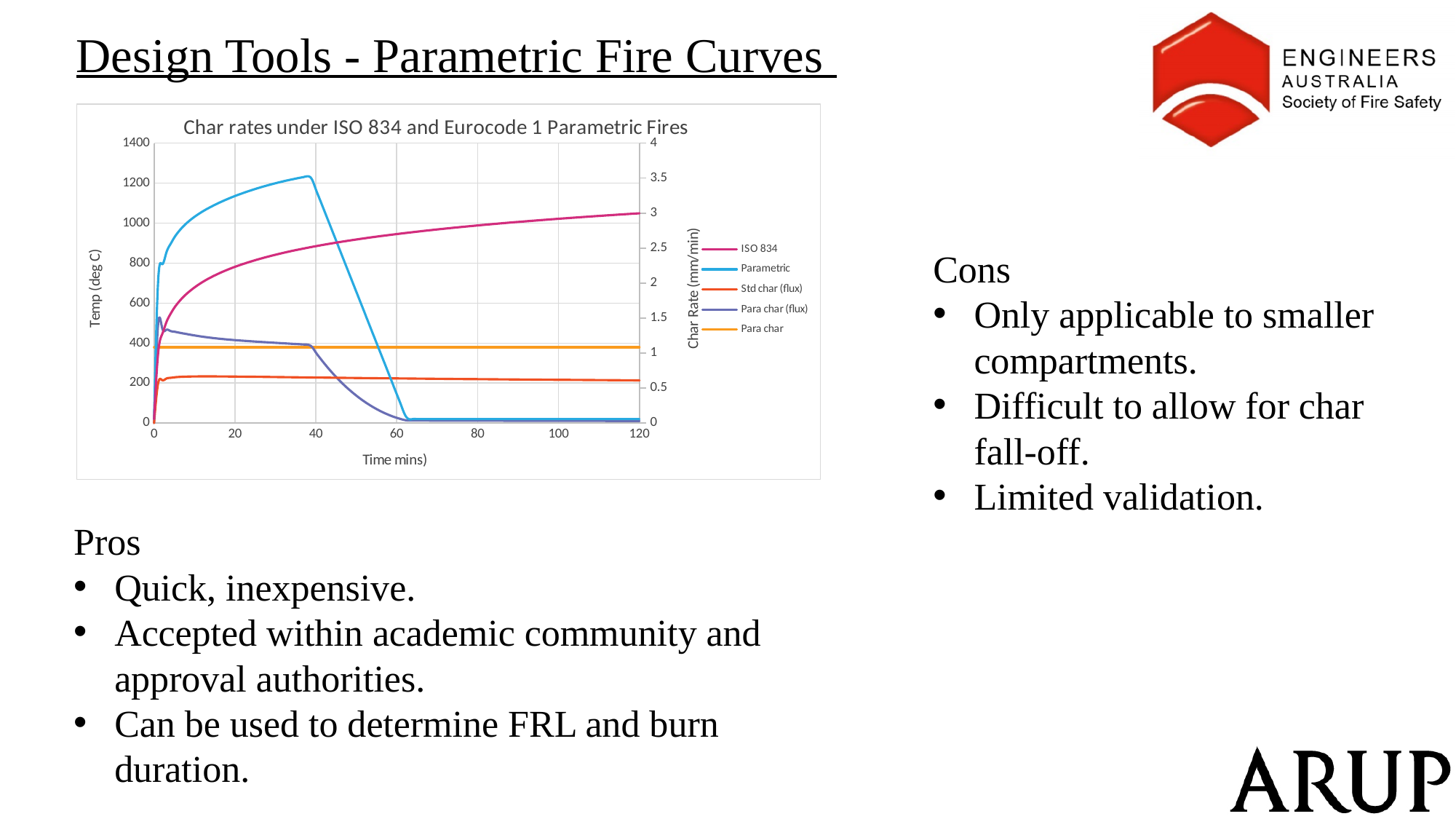
How many series does the chart legend list? 5 Is the Std char (flux) char rate at 60 minutes greater or less than 1? less What is the title of the chart? Char rates under ISO 834 and Eurocode 1 Parametric Fires Is the Parametric temperature at 80 minutes greater or less than 200? less Which temperature curve reaches the highest peak value, ISO 834 or Parametric? Parametric What kind of chart is shown on the slide? line chart At 20 minutes, which is higher: the Parametric temperature or the ISO 834 temperature? Parametric Does the ISO 834 temperature rise or fall as time increases from 0 to 120 minutes? rise Is the ISO 834 temperature at 120 minutes greater or less than 1000? greater What is the label of the right-hand vertical axis of the chart? Char Rate (mm/min)